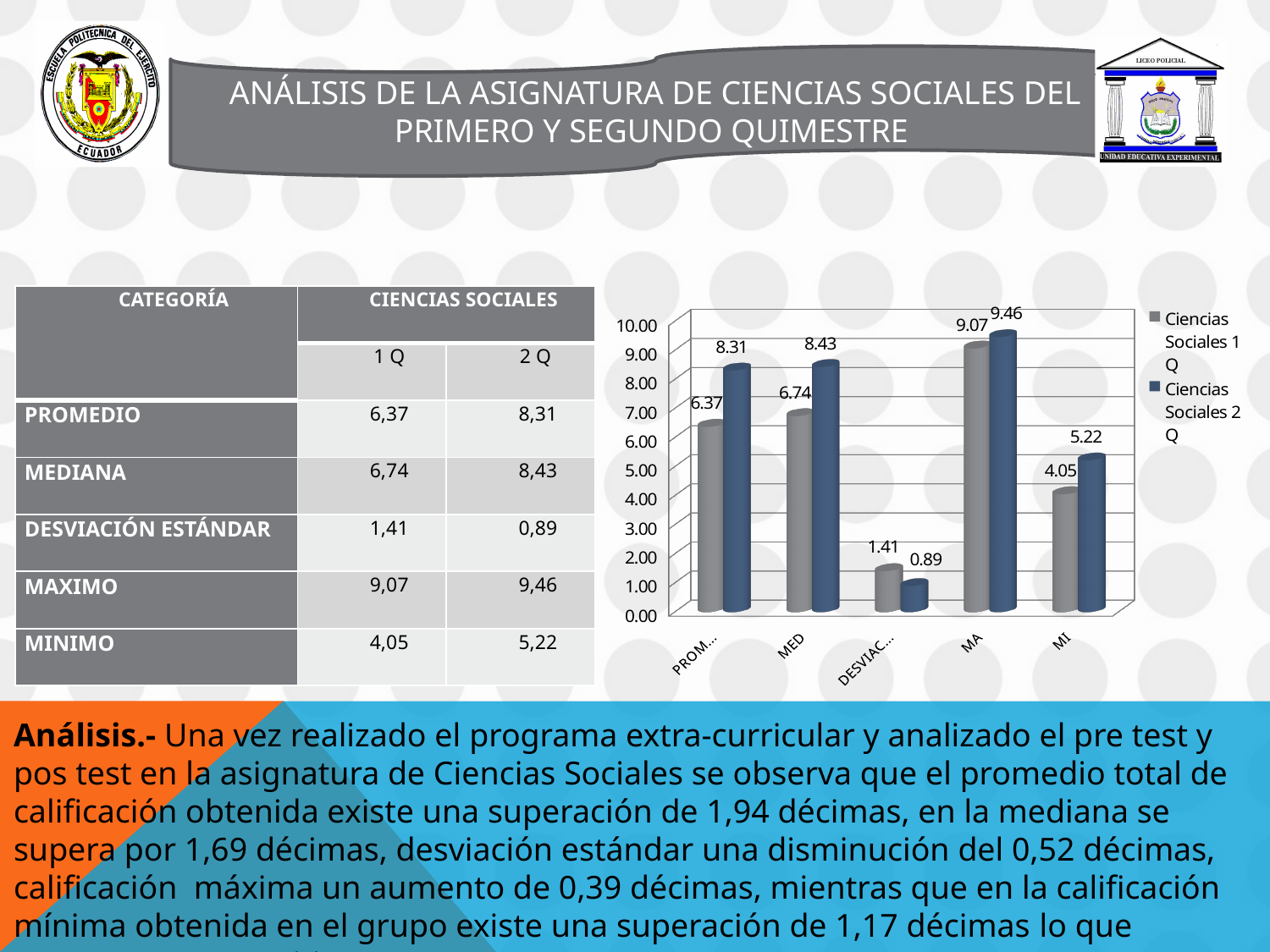
How many categories are plotted along the x axis of the chart? 5 What is the difference between the Ciencias Sociales 2 Q and Ciencias Sociales 1 Q values for the MI category? 1.17 What kind of chart is shown on the slide? bar chart What are the two legend entries of the chart? Ciencias Sociales 1 Q and Ciencias Sociales 2 Q Is the value of Ciencias Sociales 2 Q for the MED category greater or less than 8.00? greater What is the value of Ciencias Sociales 1 Q for the MI category? 4.05 How many series does the chart legend list? 2 What is the value of Ciencias Sociales 2 Q for the MA category? 9.46 For the DESVIAC... category, which series has the larger value, Ciencias Sociales 1 Q or Ciencias Sociales 2 Q? Ciencias Sociales 1 Q Which category has the highest value for Ciencias Sociales 2 Q? MA Which category has the lowest value for Ciencias Sociales 1 Q? DESVIAC... What is the value of Ciencias Sociales 1 Q for the MED category? 6.74